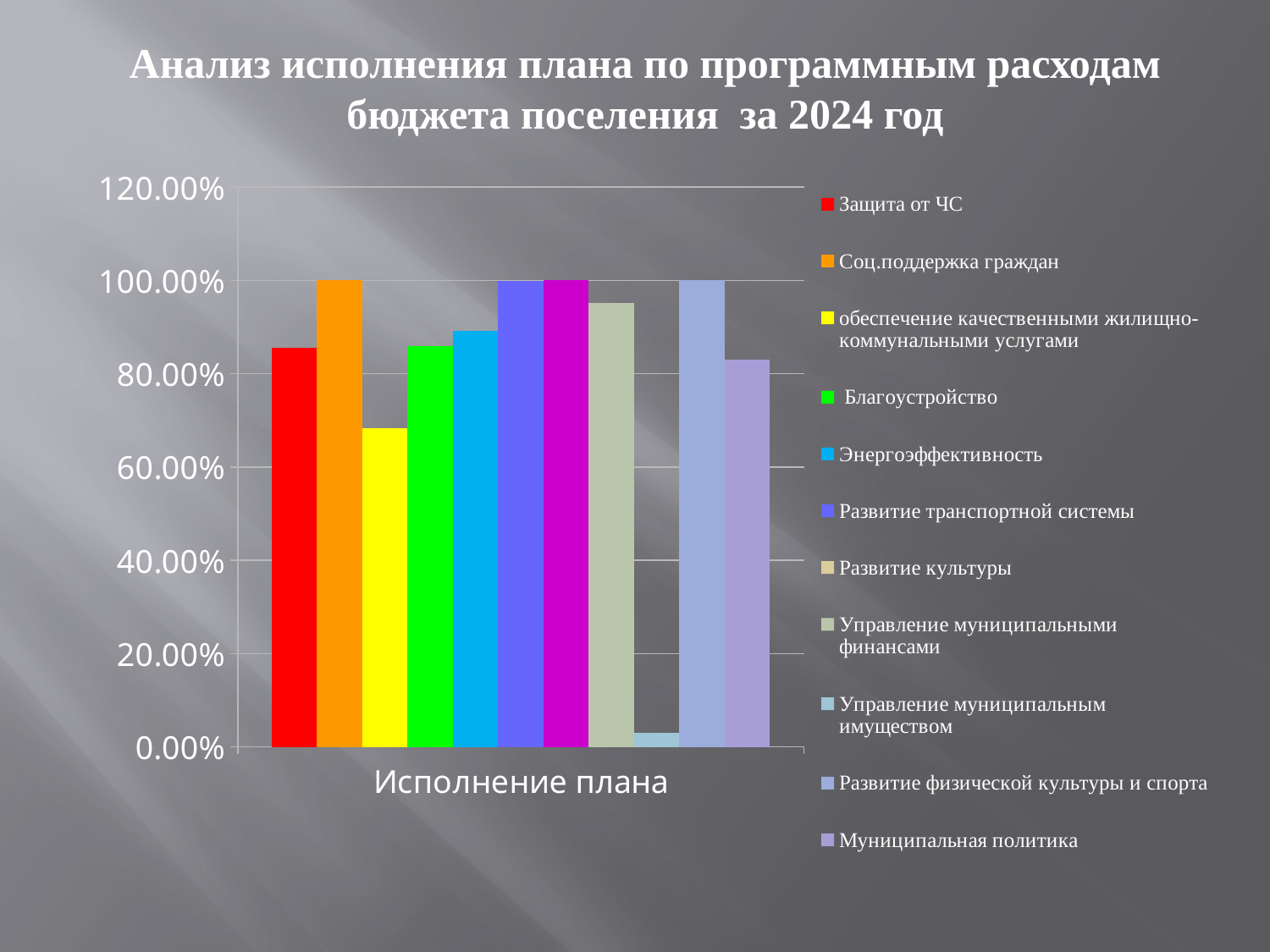
Which is larger, the value for Благоустройство or the value for обеспечение качественными жилищно-коммунальными услугами? Благоустройство How many categories are shown on the x axis? 1 Which series has the lowest value? Управление муниципальным имуществом What kind of chart is shown on the slide? bar chart What is the label shown on the x axis of the chart? Исполнение плана Is the value for Управление муниципальным имуществом greater or less than 20.00%? less Is the value for обеспечение качественными жилищно-коммунальными услугами greater or less than 80.00%? less How many series does the legend list? 11 Is the value for Защита от ЧС greater or less than 80.00%? greater What is the value for Развитие физической культуры и спорта? 100.00%